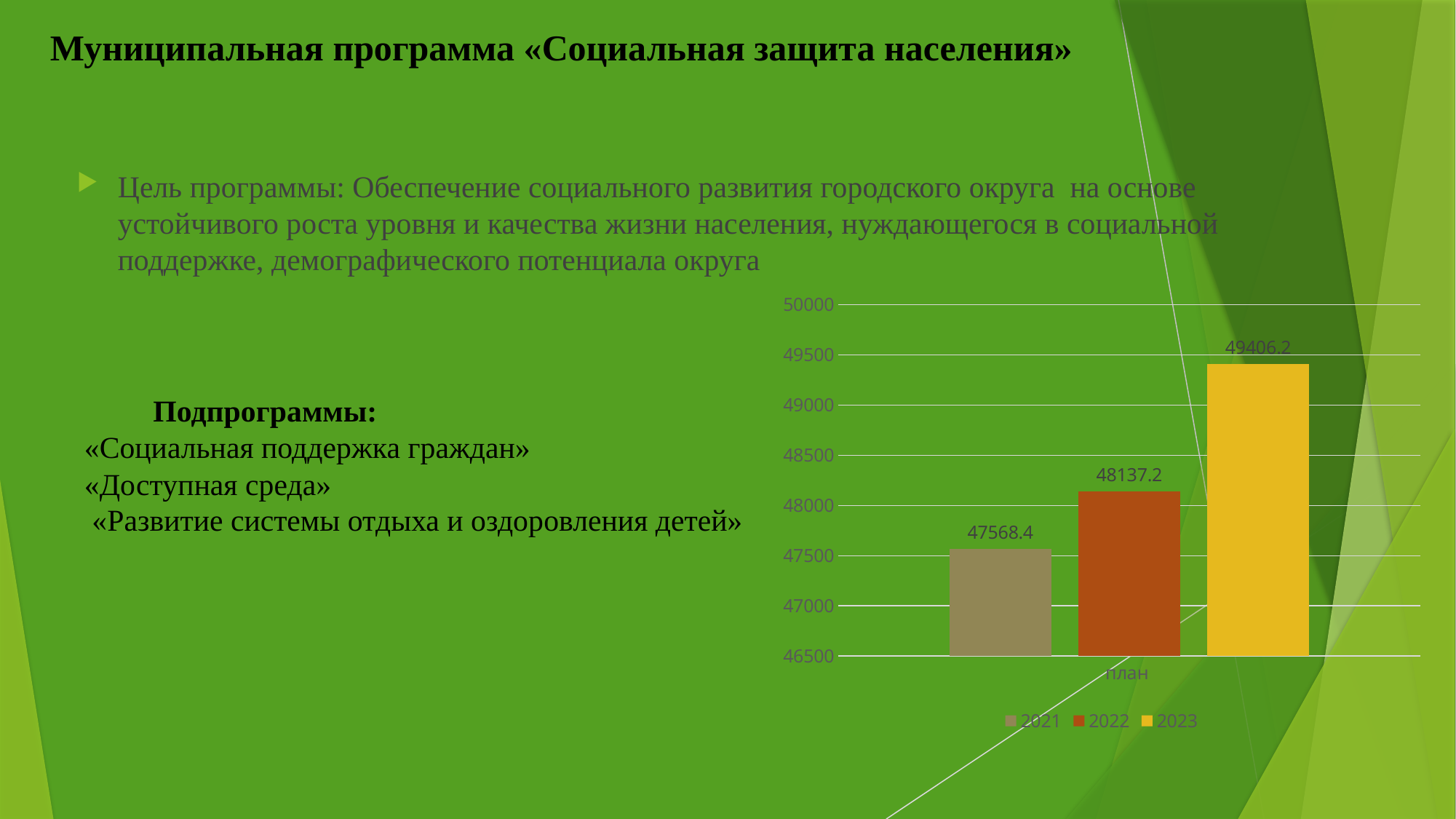
What is the value for the 2021 series in the chart? 47568.4 What kind of chart is shown on the slide? bar chart What is the category label shown on the x axis of the chart? план What is the value for the 2023 series in the chart? 49406.2 Which is larger, the value for 2021 or the value for 2022? 2022 Is the value for 2023 greater or less than 49000? greater What is the difference between the 2022 value and the 2021 value? 568.8 How many series does the legend list? 3 What is the difference between the 2023 value and the 2022 value? 1269 Which series has the lowest value in the chart? 2021 What is the value for the 2022 series in the chart? 48137.2 Which series has the highest value in the chart? 2023